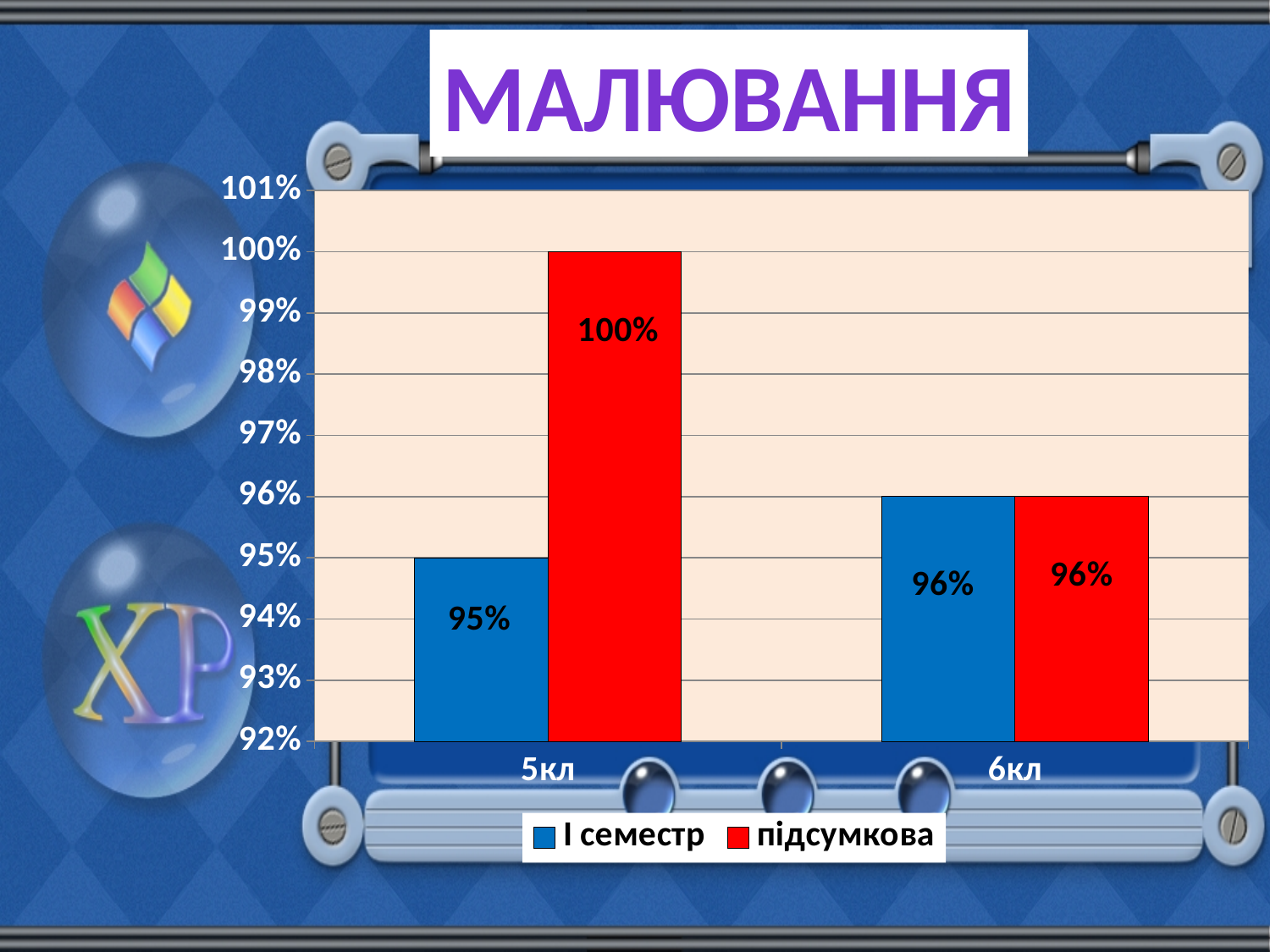
What is the title of the chart? МАЛЮВАННЯ What is the value for 5кл in the підсумкова series? 100% What kind of chart is shown on the slide? bar chart How many series does the legend list? 2 What is the difference between the підсумкова and І семестр values for 5кл? 5% What is the value for 5кл in the І семестр series? 95% Which category has the highest value in the підсумкова series? 5кл Which category has the lowest value in the І семестр series? 5кл What is the value for 6кл in the підсумкова series? 96% How many categories are shown on the x axis? 2 What is the value for 6кл in the І семестр series? 96% Which is larger for 5кл: the І семестр value or the підсумкова value? підсумкова